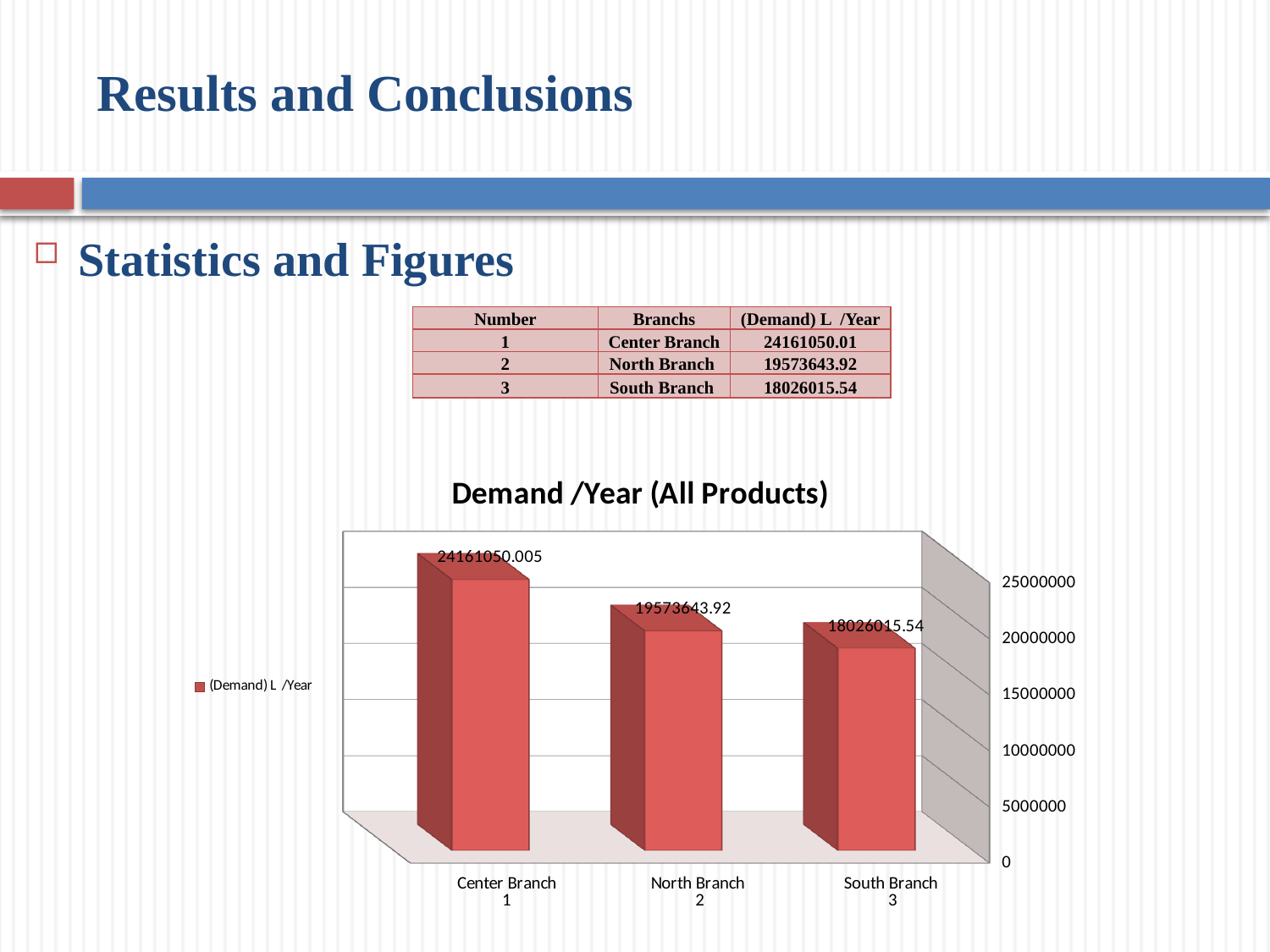
What is the value shown for Center Branch in the chart? 24161050.005 What is the title of the chart? Demand /Year (All Products) What is the difference between the North Branch and South Branch values in the chart? 1547628.38 Which branch has the lowest demand per year? South Branch What is the value shown for North Branch in the chart? 19573643.92 How many branches are plotted in the chart? 3 Which is larger, the value for Center Branch or the value for North Branch? Center Branch What kind of chart is shown on the slide? bar chart Which branch has the highest demand per year? Center Branch What is the value shown for South Branch in the chart? 18026015.54 Is the value for Center Branch greater or less than 20000000? greater Do the values rise or fall from Center Branch to South Branch along the x axis? fall